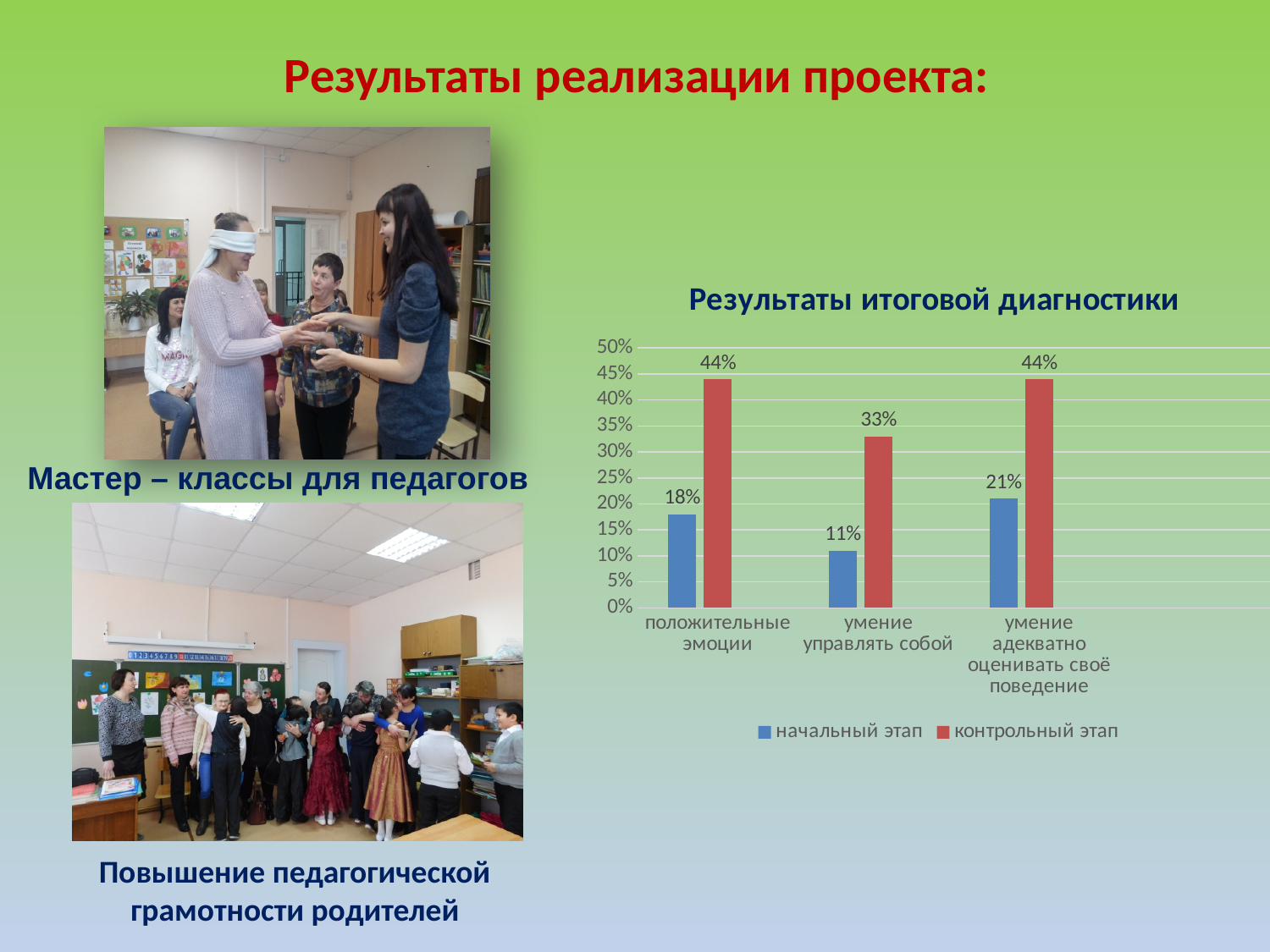
What is the difference between the "контрольный этап" and "начальный этап" values for "положительные эмоции"? 26% How many categories are shown on the x axis of the chart? 3 What is the value for "контрольный этап" in the category "умение управлять собой"? 33% What is the title of the chart? Результаты итоговой диагностики Which is larger for "умение адекватно оценивать своё поведение": the "начальный этап" value or the "контрольный этап" value? контрольный этап How many series does the chart legend list? 2 What is the value for "начальный этап" in the category "положительные эмоции"? 18% What is the difference between the "контрольный этап" and "начальный этап" values for "умение управлять собой"? 22% What is the value for "начальный этап" in the category "умение адекватно оценивать своё поведение"? 21% Which category has the lowest value for "начальный этап"? умение управлять собой What kind of chart is shown on the slide? bar chart Which category has the lowest value for "контрольный этап"? умение управлять собой